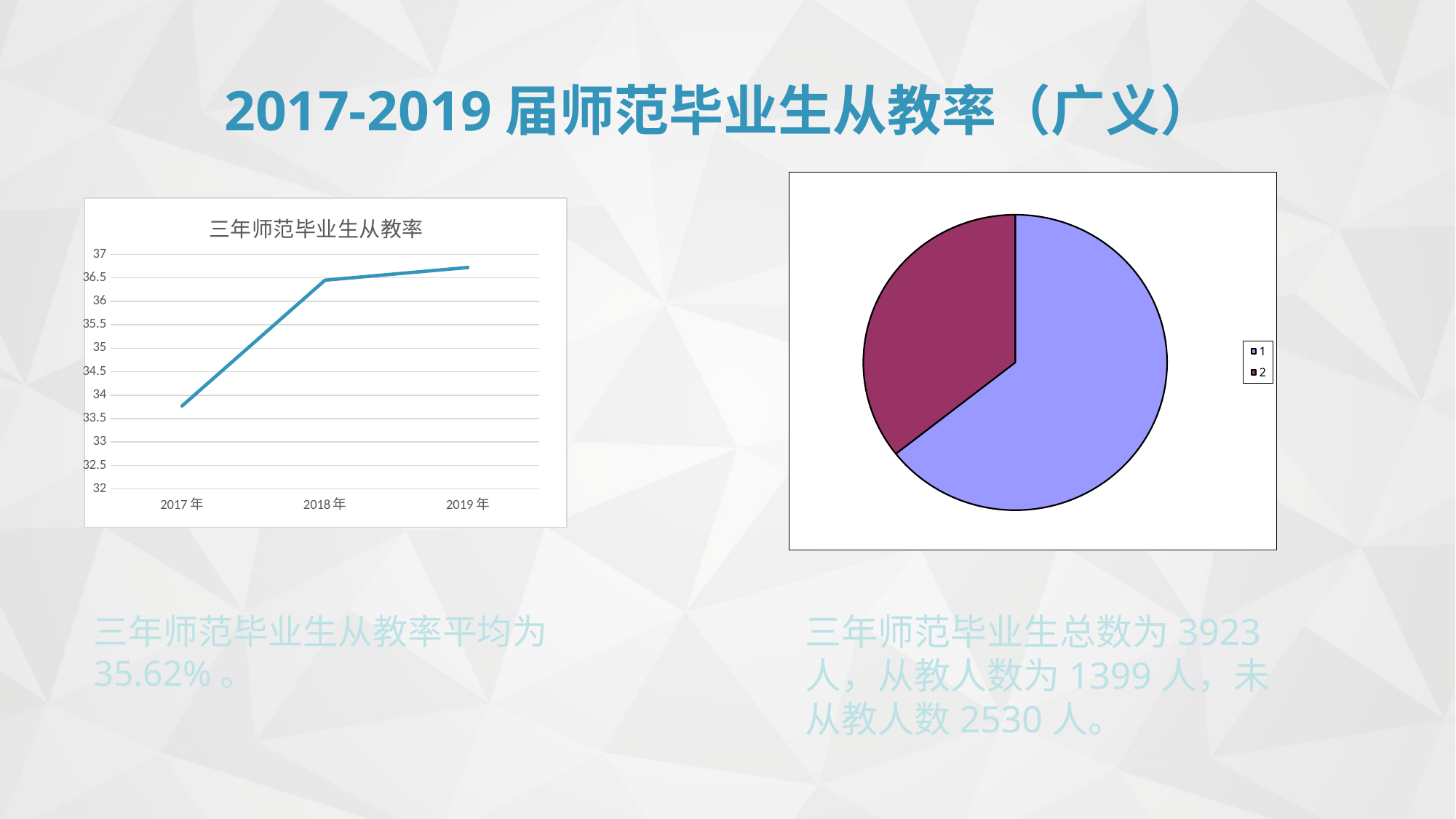
In the chart titled 三年师范毕业生从教率, which year has the lowest value? 2017年 In the chart titled 三年师范毕业生从教率, how many years are plotted on the x axis? 3 In the chart titled 三年师范毕业生从教率, which is larger, the value for 2017年 or the value for 2018年? 2018年 In the chart titled 三年师范毕业生从教率, is the value for 2018年 greater or less than 36? greater How many entries does the legend of the pie chart on the right list? 2 In the pie chart on the right, which slice is larger, 1 or 2? 1 What kind of chart is the chart on the right of the slide? pie chart In the chart titled 三年师范毕业生从教率, do the values rise or fall from 2017年 to 2019年? rise What kind of chart is the chart on the left titled 三年师范毕业生从教率? line chart In the chart titled 三年师范毕业生从教率, is the value for 2019年 greater or less than 36? greater In the chart titled 三年师范毕业生从教率, is the value for 2017年 greater or less than 34? less What is the title of the line chart on the left? 三年师范毕业生从教率